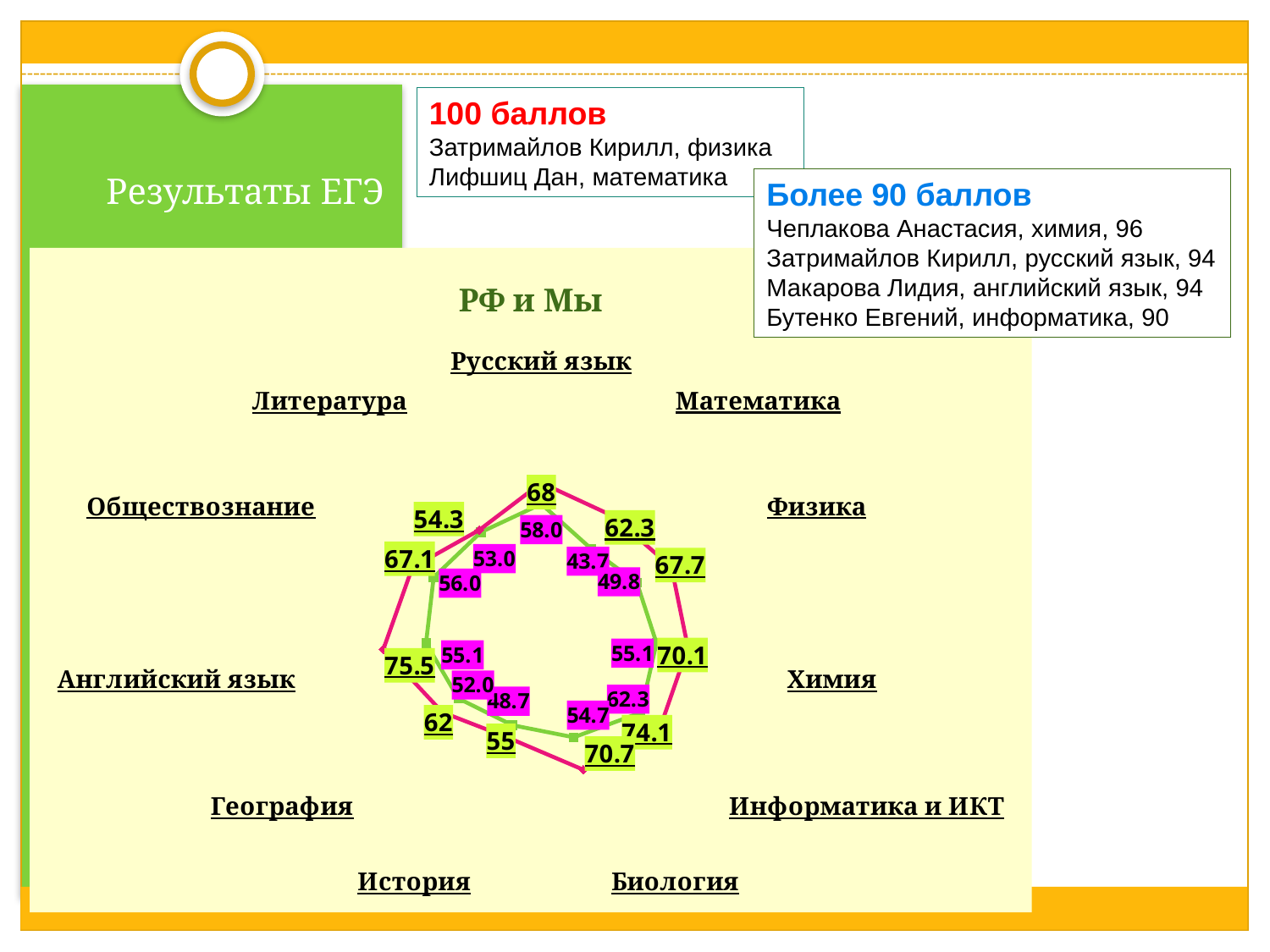
What is the title of the chart? РФ и Мы How many data series are plotted on the chart? 2 What is the magenta-labelled value for Математика? 43.7 What is the green-labelled value for Русский язык? 68 Which subject has the lowest magenta-labelled value? Математика What kind of chart is shown on the slide? radar chart What is the magenta-labelled value for Химия? 55.1 What is the difference between the green-labelled and magenta-labelled values for Русский язык? 10.0 Which subject has the highest green-labelled value? Английский язык What is the green-labelled value for Информатика и ИКТ? 74.1 For Физика, which is larger: the green-labelled value or the magenta-labelled value? the green-labelled value (67.7) How many subject categories are plotted on the chart? 11